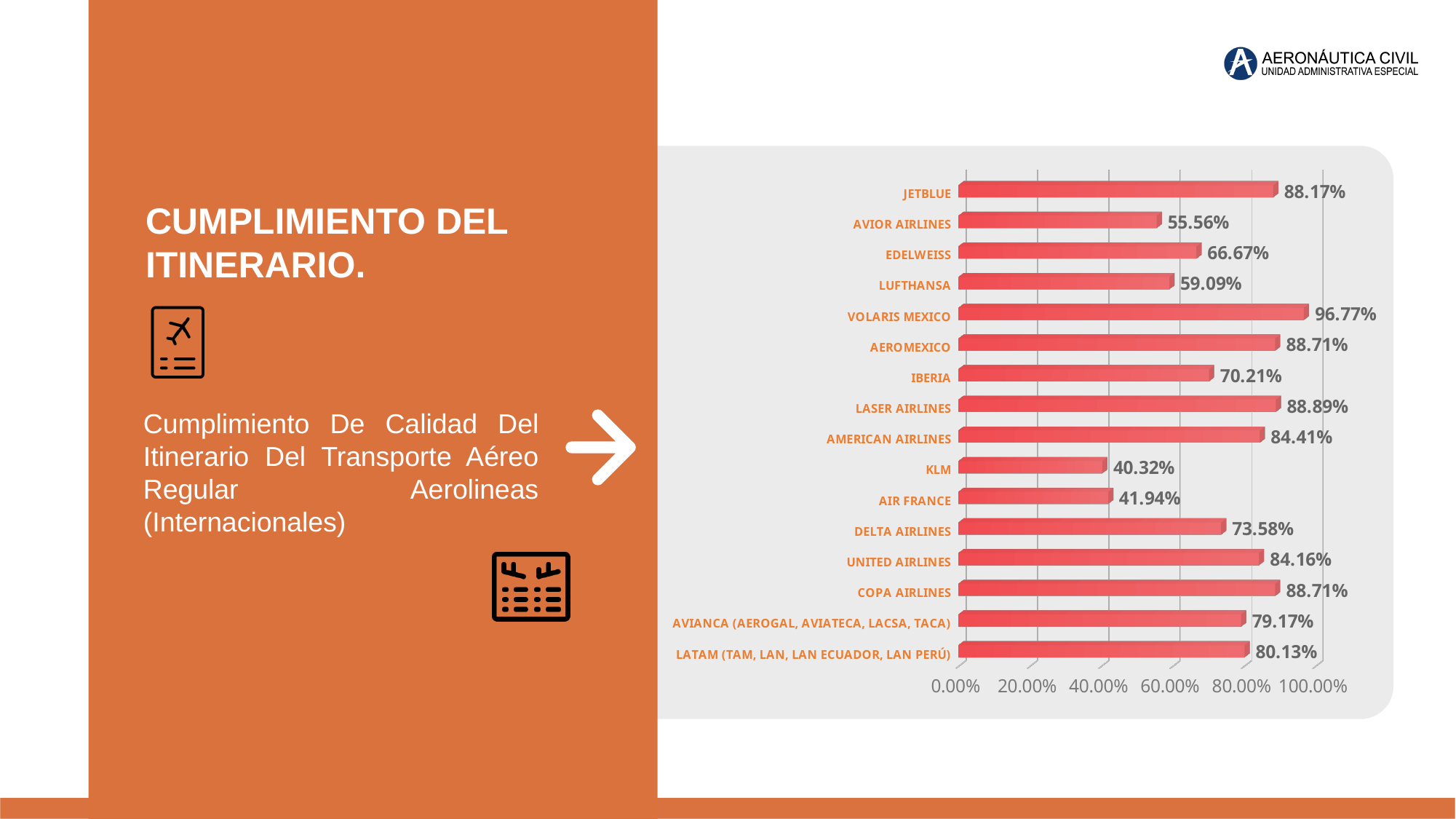
What is the difference between the values for JETBLUE and AVIOR AIRLINES? 32.61% Which is larger, the value for IBERIA or the value for DELTA AIRLINES? DELTA AIRLINES What is the value for DELTA AIRLINES? 73.58% What is the difference between the values for VOLARIS MEXICO and KLM? 56.45% What is the value for AVIANCA (AEROGAL, AVIATECA, LACSA, TACA)? 79.17% What is the value for VOLARIS MEXICO? 96.77% What kind of chart is shown on the slide? bar chart Is the value for AIR FRANCE greater or less than 60.00%? less Which airline has the highest value? VOLARIS MEXICO How many airlines are shown in the chart? 16 Which airline has the lowest value? KLM What is the value for KLM? 40.32%